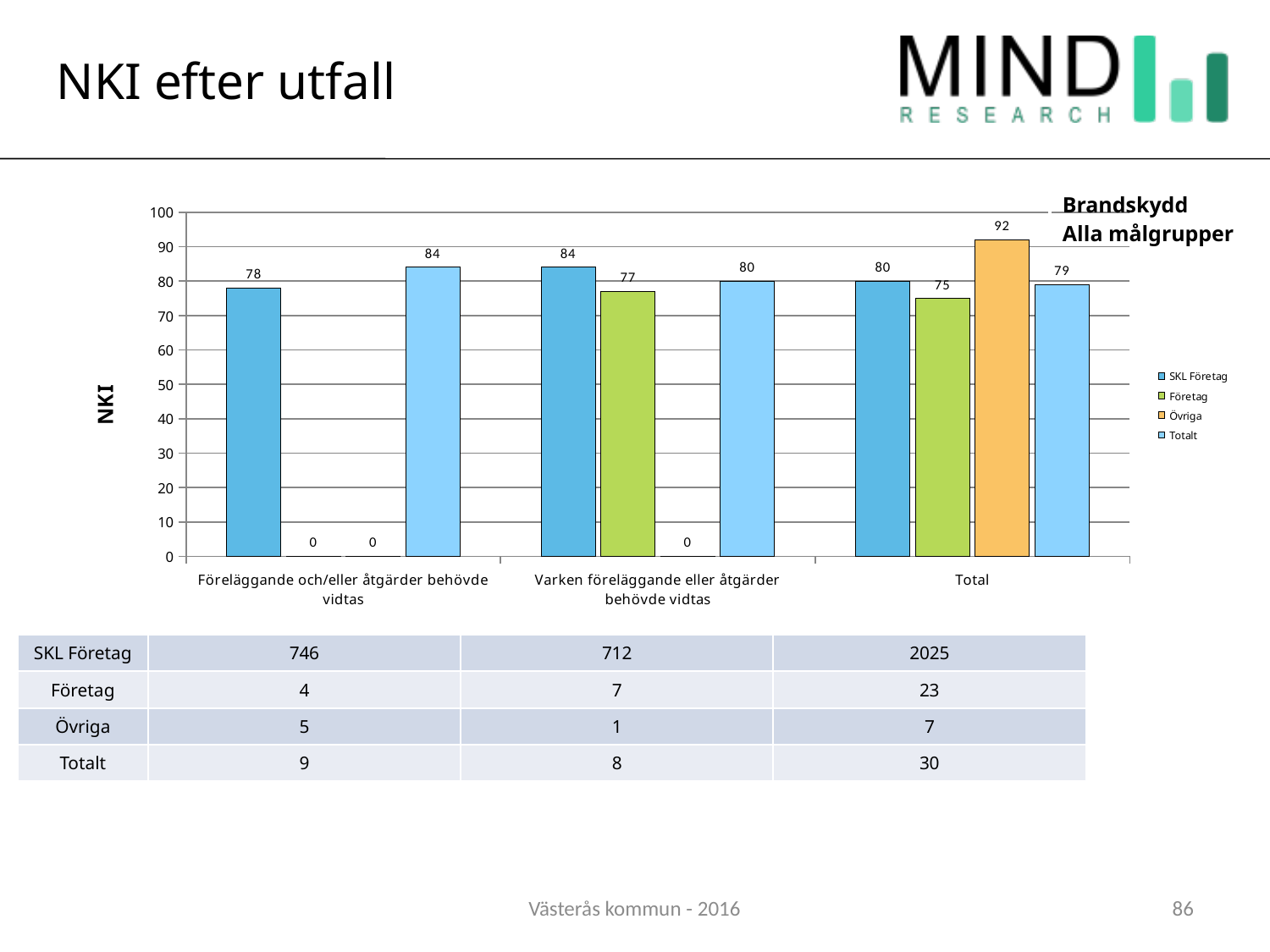
Which is larger: the Totalt value for 'Föreläggande och/eller åtgärder behövde vidtas' or the Totalt value for 'Varken föreläggande eller åtgärder behövde vidtas'? Föreläggande och/eller åtgärder behövde vidtas How many categories are shown on the x axis of the chart? 3 What is the NKI value for Övriga in the 'Total' category? 92 What is the NKI value for Totalt in the 'Total' category? 79 Which series has the highest NKI value in the 'Total' category? Övriga What is the difference between the SKL Företag values for 'Varken föreläggande eller åtgärder behövde vidtas' and 'Föreläggande och/eller åtgärder behövde vidtas'? 6 What is the NKI value for SKL Företag in the category 'Föreläggande och/eller åtgärder behövde vidtas'? 78 What type of chart is shown on the slide? Bar chart What is the label of the y axis of the chart? NKI Which series has the lowest NKI value in the 'Total' category? Företag What is the NKI value for Företag in the category 'Varken föreläggande eller åtgärder behövde vidtas'? 77 How many series does the chart legend list? 4